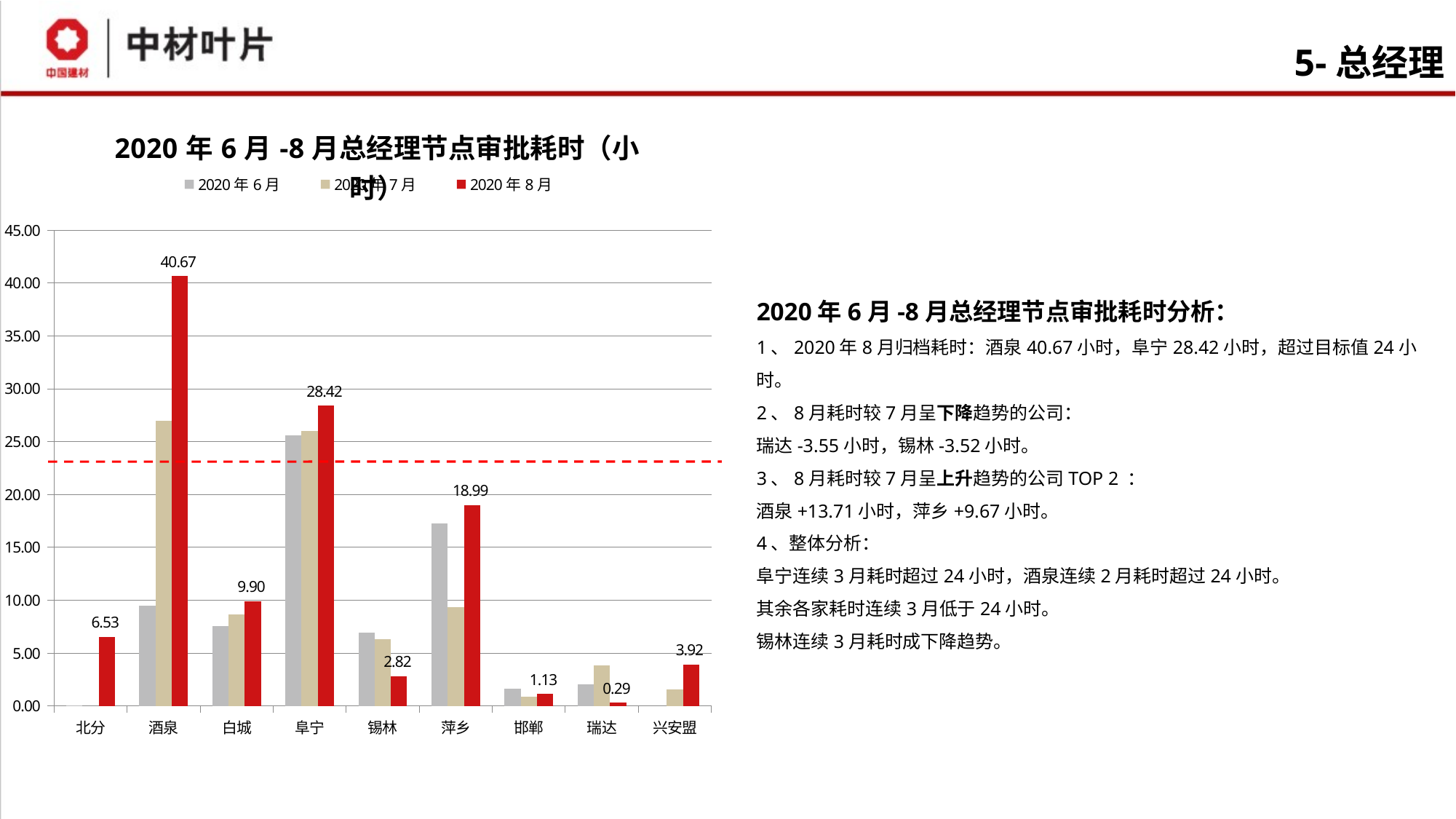
What kind of chart is shown on the slide? bar chart How many series does the legend list? 3 What is the 2020年8月 value for 瑞达? 0.29 What is the 2020年8月 value for 兴安盟? 3.92 What is the difference between the 2020年8月 values for 酒泉 and 阜宁? 12.25 Which category has the highest 2020年8月 value? 酒泉 Which category has the lowest 2020年8月 value? 瑞达 What is the 2020年8月 value for 酒泉? 40.67 What is the 2020年8月 value for 阜宁? 28.42 How many categories are shown on the x axis? 9 Is the 2020年7月 value for 酒泉 greater or less than 25.00? greater Which is larger, the 2020年8月 value for 萍乡 or for 白城? 萍乡